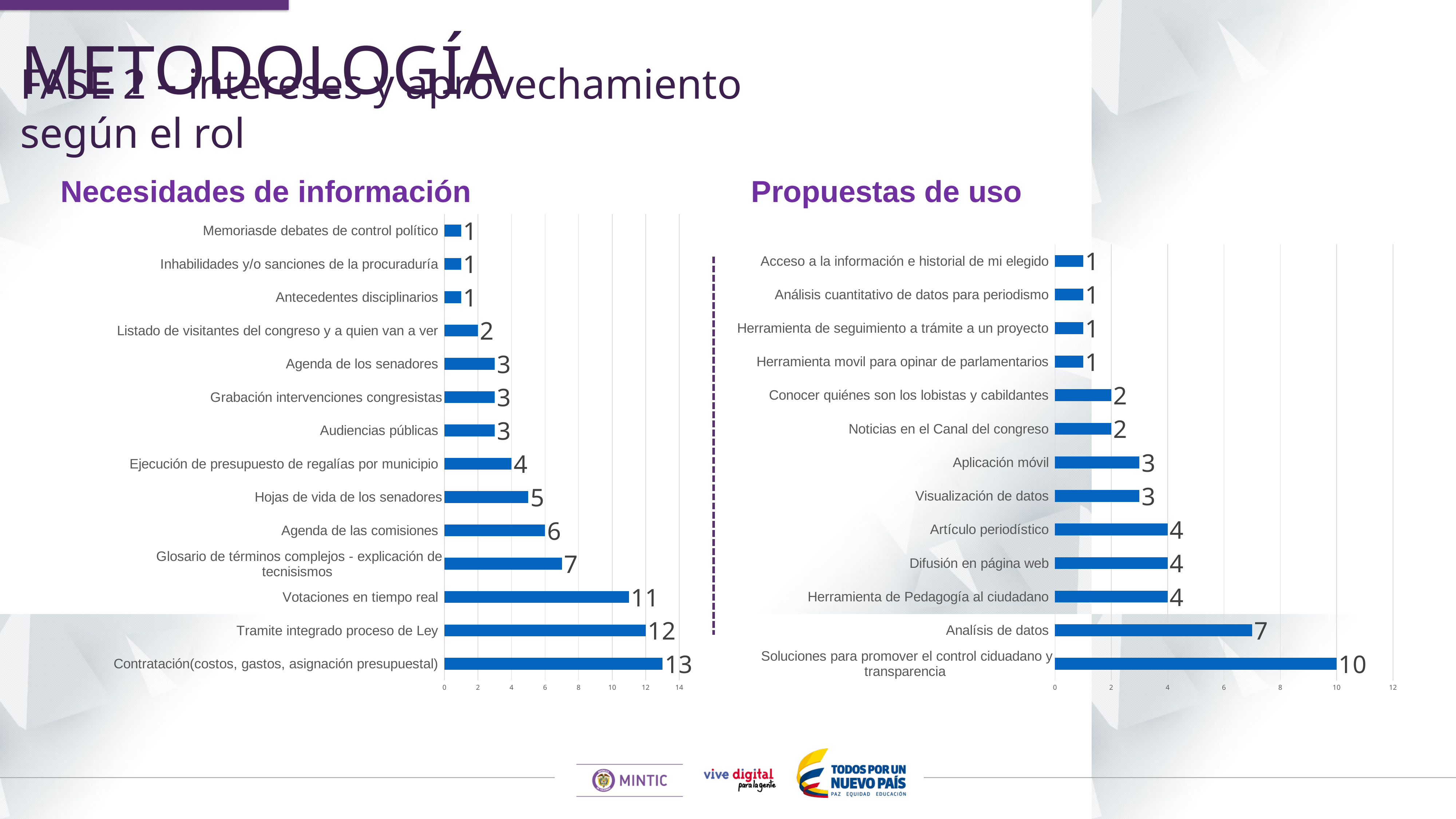
In the 'Necesidades de información' chart, which category has the highest value? Contratación(costos, gastos, asignación presupuestal) In the 'Necesidades de información' chart, what is the value for Votaciones en tiempo real? 11 In the 'Propuestas de uso' chart, what is the value for Análisis de datos? 7 In the 'Propuestas de uso' chart, which is larger: Aplicación móvil or Artículo periodístico? Artículo periodístico In the 'Necesidades de información' chart, what is the difference between Tramite integrado proceso de Ley and Agenda de las comisiones? 6 In the 'Propuestas de uso' chart, how many categories are shown? 13 In the 'Necesidades de información' chart, what is the value for Hojas de vida de los senadores? 5 In the 'Necesidades de información' chart, is the value for Contratación(costos, gastos, asignación presupuestal) greater or less than 12? greater In the 'Propuestas de uso' chart, which category has the highest value? Soluciones para promover el control ciudadano y transparencia In the 'Propuestas de uso' chart, what is the difference between Soluciones para promover el control ciudadano y transparencia and Análisis de datos? 3 What type of chart is the 'Propuestas de uso' chart? Bar chart In the 'Necesidades de información' chart, how many categories are shown? 14